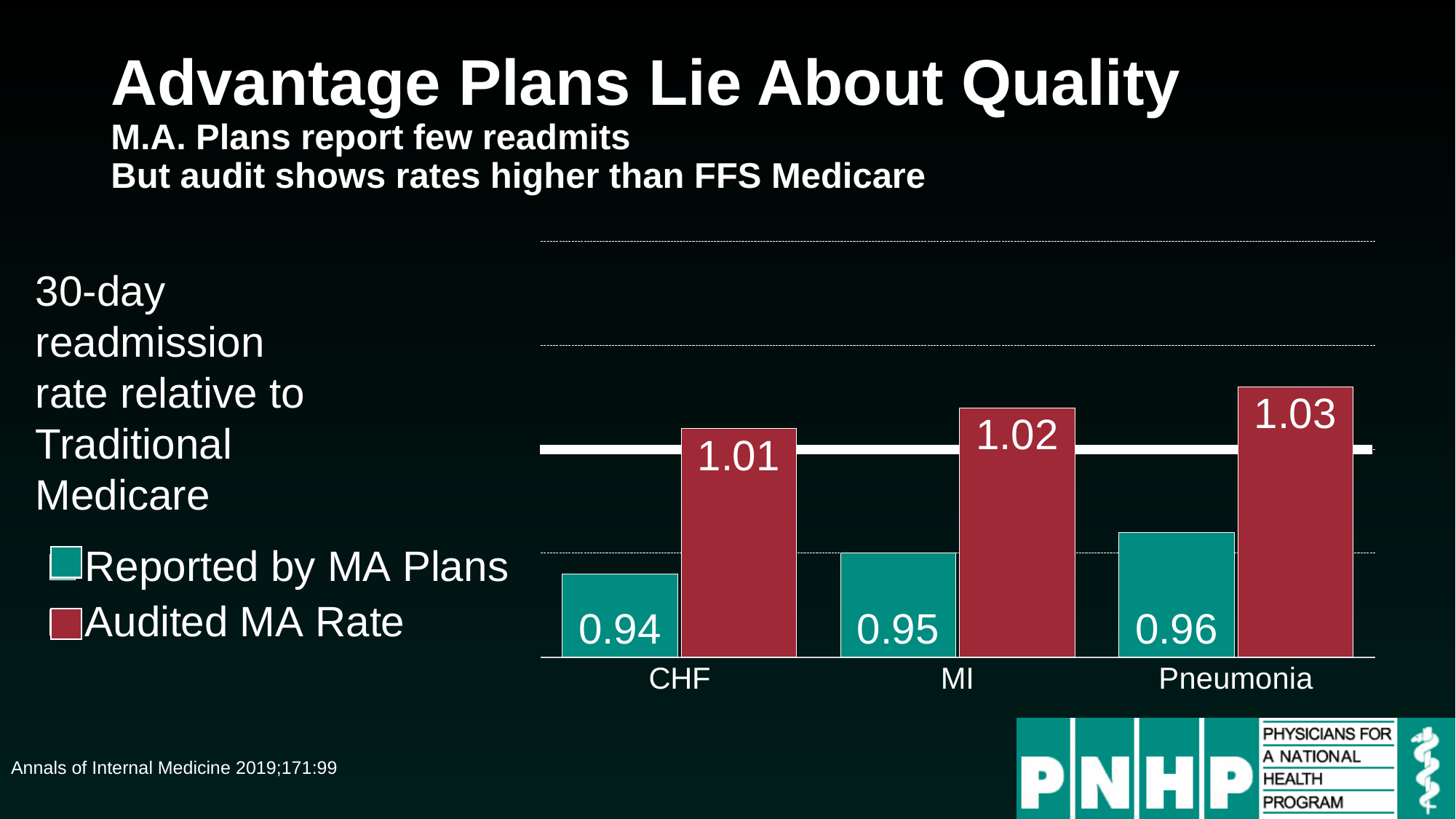
Which series is shown in red? Audited MA Rate What is the value reported by MA Plans for Pneumonia? 0.96 For MI, which is larger: the rate reported by MA Plans or the audited MA rate? Audited MA Rate What kind of chart is shown on the slide? Bar chart What is the difference between the audited MA rate and the rate reported by MA Plans for CHF? 0.07 What is the audited MA rate for Pneumonia? 1.03 How many series does the legend list? 2 Which category has the lowest value reported by MA Plans? CHF Which category has the highest audited MA rate? Pneumonia How many categories are shown on the x axis? 3 What is the value reported by MA Plans for CHF? 0.94 What is the audited MA rate for MI? 1.02